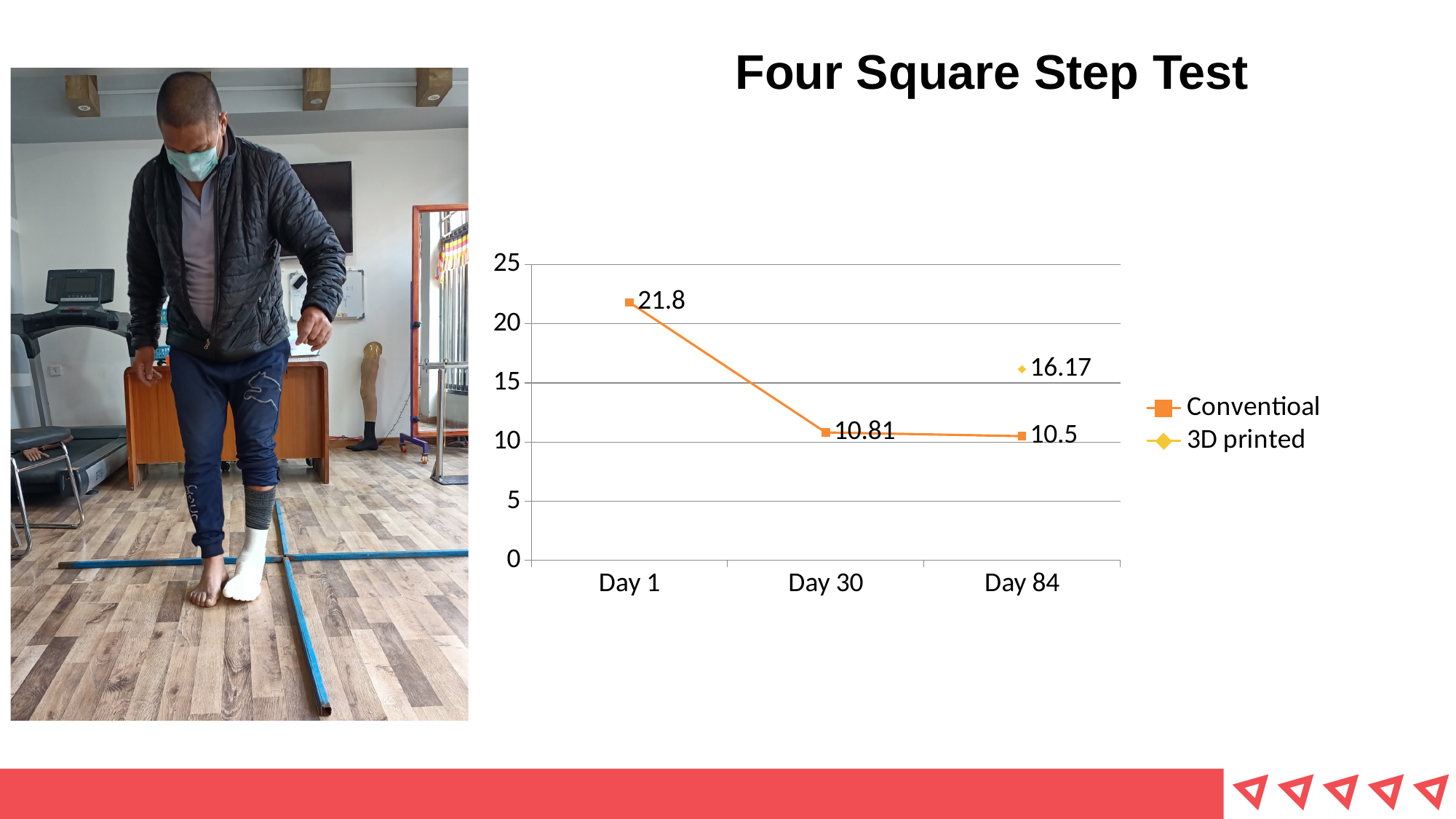
What is the Conventioal value on Day 30? 10.81 What is the 3D printed value on Day 84? 16.17 How many series does the legend list? 2 On which day is the Conventioal series highest? Day 1 What is the difference between the Conventioal values on Day 1 and Day 30? 10.99 On Day 84, which series has the larger value, Conventioal or 3D printed? 3D printed On which day is the Conventioal series lowest? Day 84 What kind of chart is shown? Line chart What is the Conventioal value on Day 1? 21.8 What is the Conventioal value on Day 84? 10.5 How many categories are shown on the x axis? 3 Does the Conventioal series rise or fall from Day 1 to Day 84? Fall